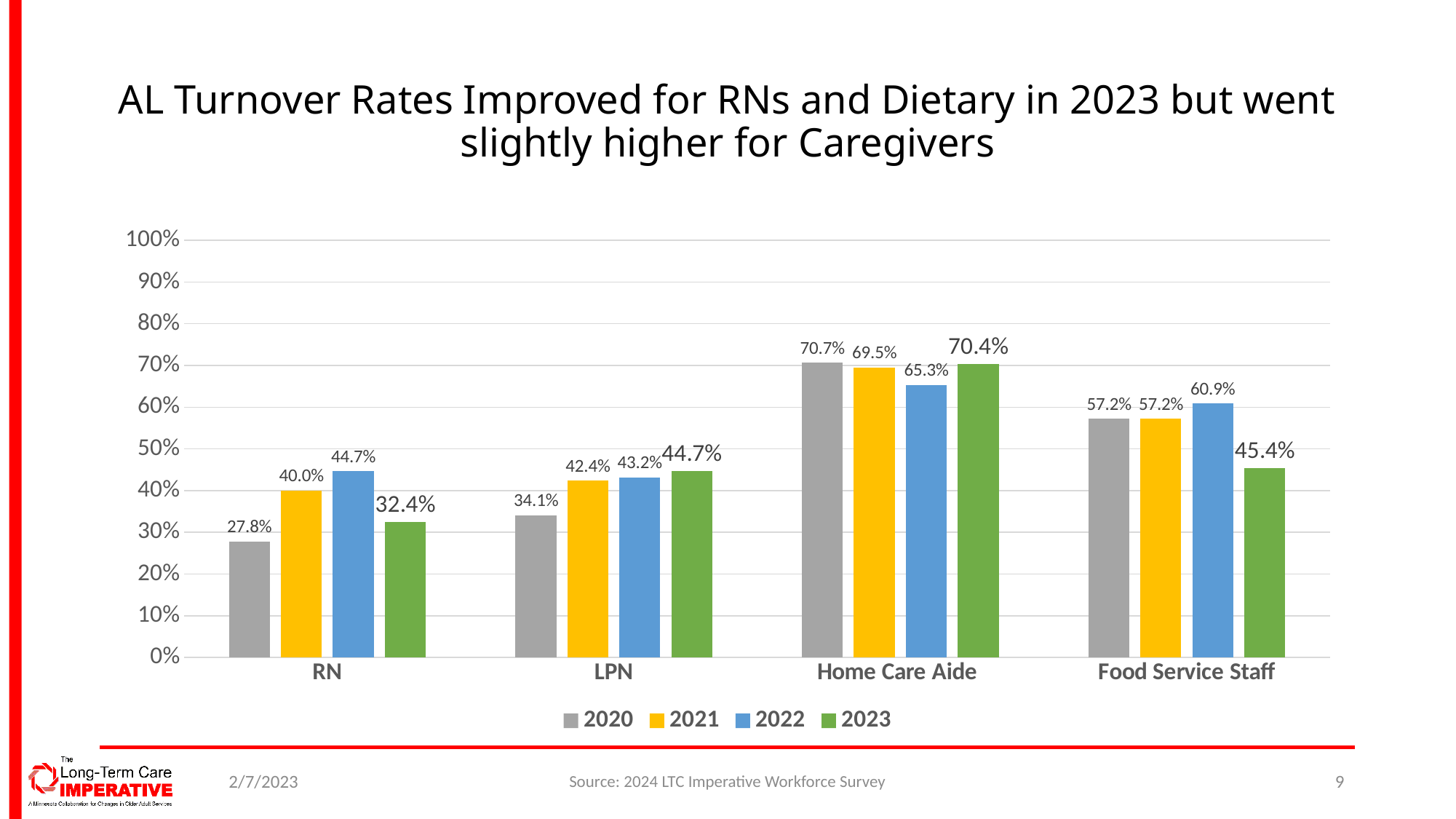
What kind of chart is shown on the slide? Bar chart What was the turnover rate for RN in 2023? 32.4% How many series does the legend list? 4 Is the 2020 turnover rate for Home Care Aide greater or less than 60%? greater Which category had the lowest turnover rate in 2020? RN What is the difference between the 2022 and 2023 turnover rates for Food Service Staff? 15.5% Which is larger, the 2021 turnover rate for LPN or the 2021 turnover rate for RN? LPN What was the turnover rate for Home Care Aide in 2022? 65.3% How many job categories are shown on the x axis? 4 What was the turnover rate for Food Service Staff in 2021? 57.2% Which category had the highest turnover rate in 2023? Home Care Aide Which colour represents the 2023 series in the legend? Green